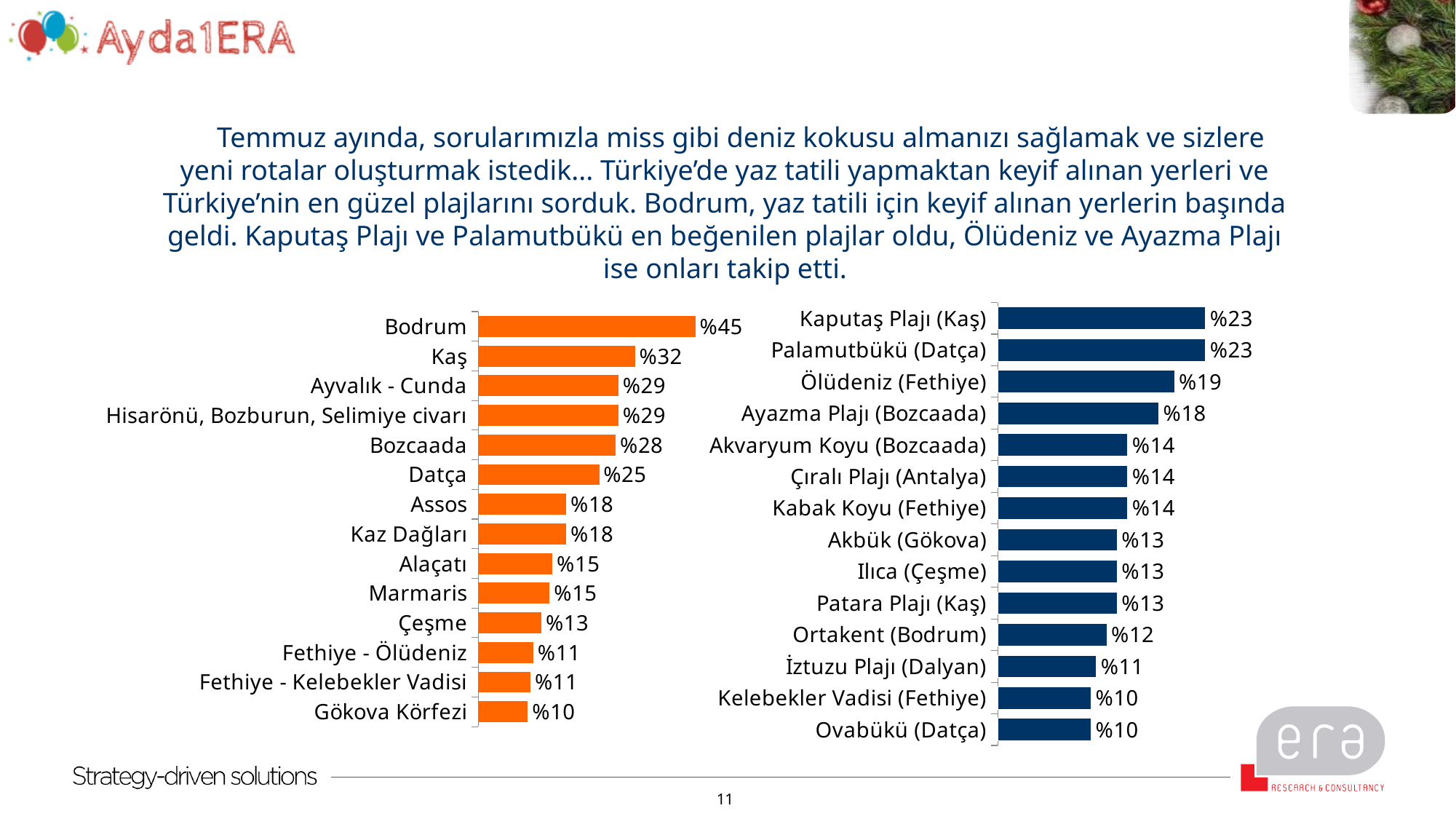
In the right (blue) chart, what is the value for Ölüdeniz (Fethiye)? %19 In the right (blue) chart, which is larger: the value for Ölüdeniz (Fethiye) or the value for Akbük (Gökova)? Ölüdeniz (Fethiye) How many categories are shown in the right (blue) chart? 14 In the right (blue) chart, what is the difference between the values for Kaputaş Plajı (Kaş) and Ayazma Plajı (Bozcaada)? 5 percentage points In the right (blue) chart, what is the value for Ortakent (Bodrum)? %12 In the left (orange) chart, which category has the highest value? Bodrum In the left (orange) chart, what is the value for Datça? %25 In the left (orange) chart, what is the difference between the values for Bodrum and Kaş? 13 percentage points In the left (orange) chart, which category has the lowest value? Gökova Körfezi How many categories are shown in the left (orange) chart? 14 In the left (orange) chart, what is the value for Bodrum? %45 What type of chart is the right (blue) chart? Bar chart